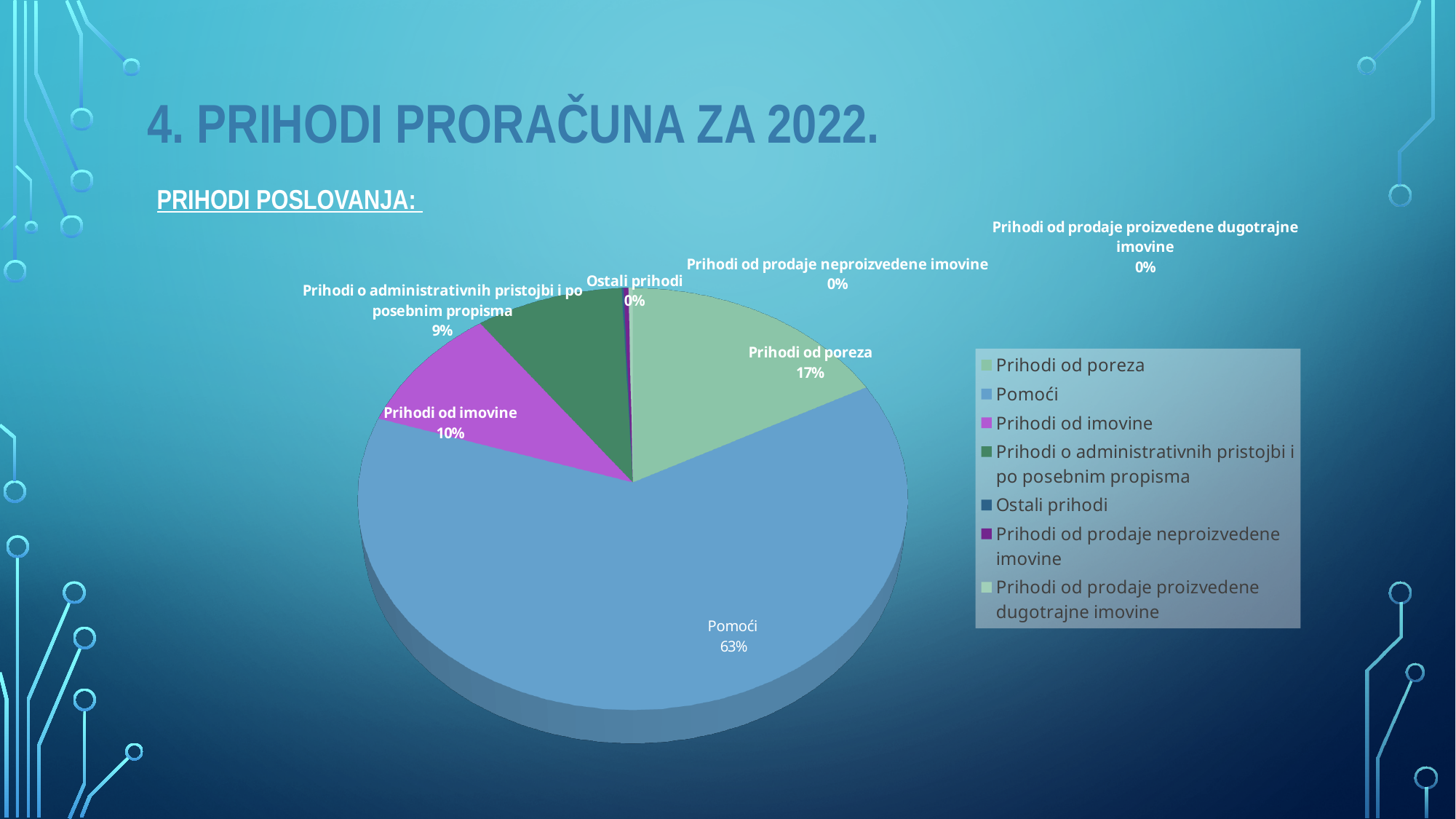
Which is larger, Prihodi od imovine or Prihodi o administrativnih pristojbi i po posebnim propisma? Prihodi od imovine What percentage is shown for Prihodi od poreza? 17% What percentage is shown for Ostali prihodi? 0% Which category has the largest share of the pie? Pomoći How many categories are labelled with 0%? 3 How many categories does the legend list? 7 What is the heading written above the chart? PRIHODI POSLOVANJA: What is the difference in percentage points between Pomoći and Prihodi od poreza? 46 What percentage is shown for Prihodi od imovine? 10% What share of the pie does Pomoći represent? 63% What kind of chart is shown on the slide? Pie chart What percentage is shown for Prihodi o administrativnih pristojbi i po posebnim propisma? 9%